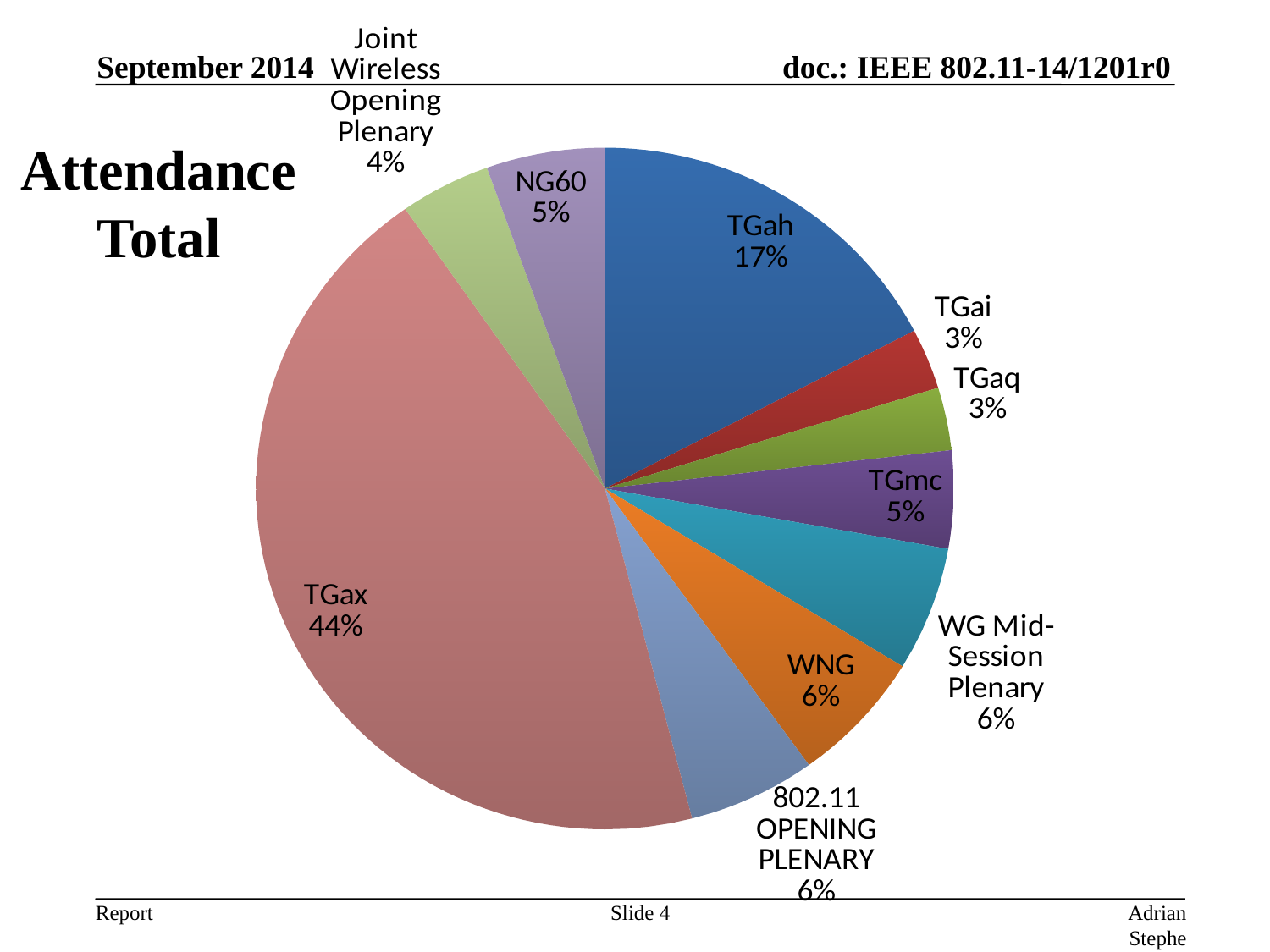
What is the value shown for NG60? 5% What is the value shown for WNG? 6% What is the difference between the share for WG Mid-Session Plenary and the share for TGaq? 3% How many slices does the pie chart have? 10 What is the title of the chart on the slide? Attendance Total Which is larger, the share for TGmc or the share for TGai? TGmc What is the difference between the TGax share and the TGah share? 27% What kind of chart is shown on the slide? pie chart Which category has the largest slice of the pie? TGax What share of the pie does TGax represent? 44% What share of the pie does TGah represent? 17% What is the value shown for the Joint Wireless Opening Plenary? 4%